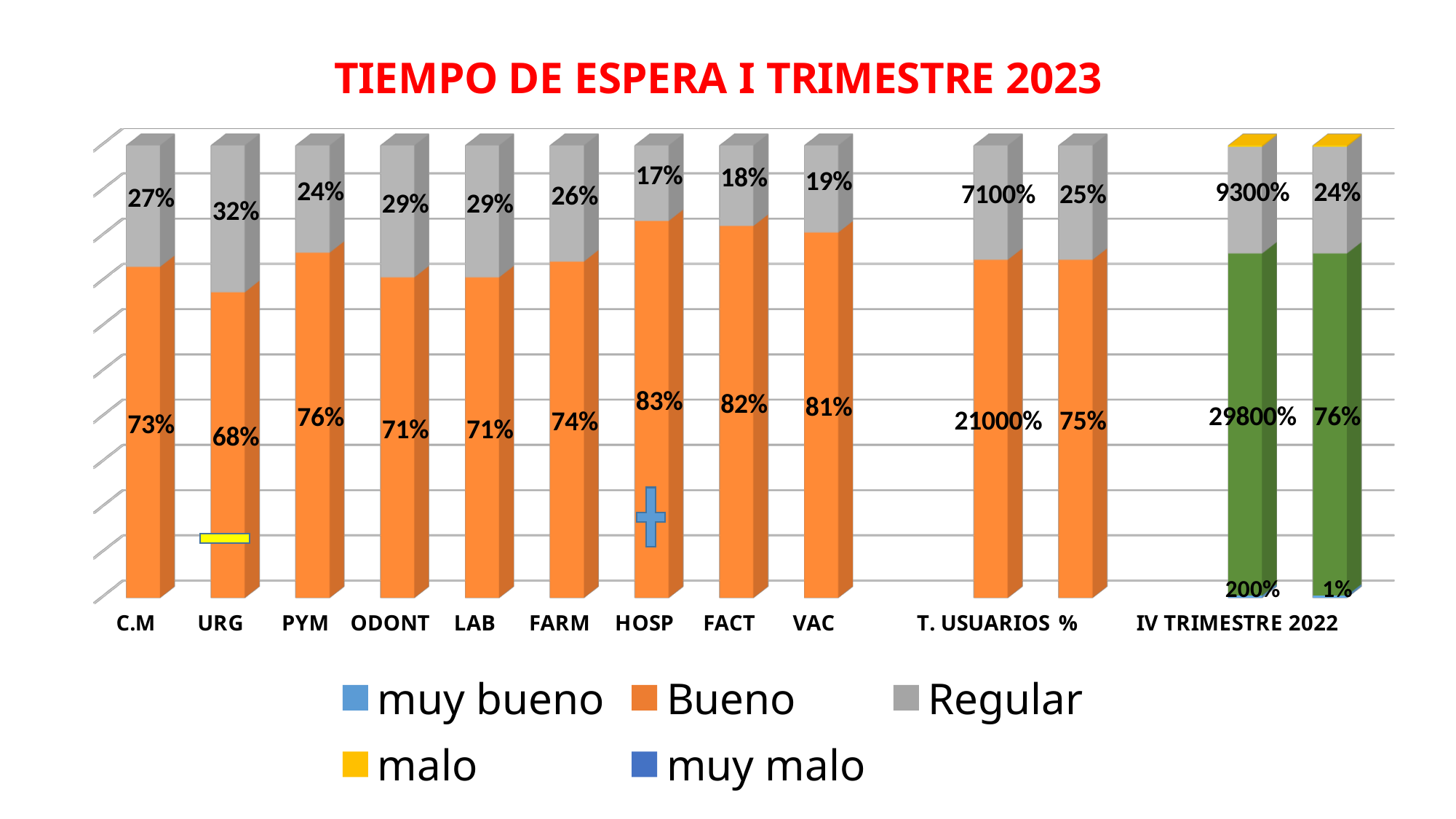
Which has a larger Regular value, PYM or ODONT? ODONT What is the Regular value for URG? 32% Which legend entry is shown in orange? Bueno What type of chart is shown on the slide? stacked bar chart Among C.M, URG, PYM, ODONT, LAB, FARM, HOSP, FACT and VAC, which category has the highest Bueno value? HOSP What is the Bueno value for C.M? 73% What is the Bueno value for HOSP? 83% Among C.M, URG, PYM, ODONT, LAB, FARM, HOSP, FACT and VAC, which category has the lowest Bueno value? URG What is the title of the chart? TIEMPO DE ESPERA I TRIMESTRE 2023 What is the difference between the Bueno values for HOSP and URG? 15% What is the Regular value for VAC? 19% How many series does the legend list? 5